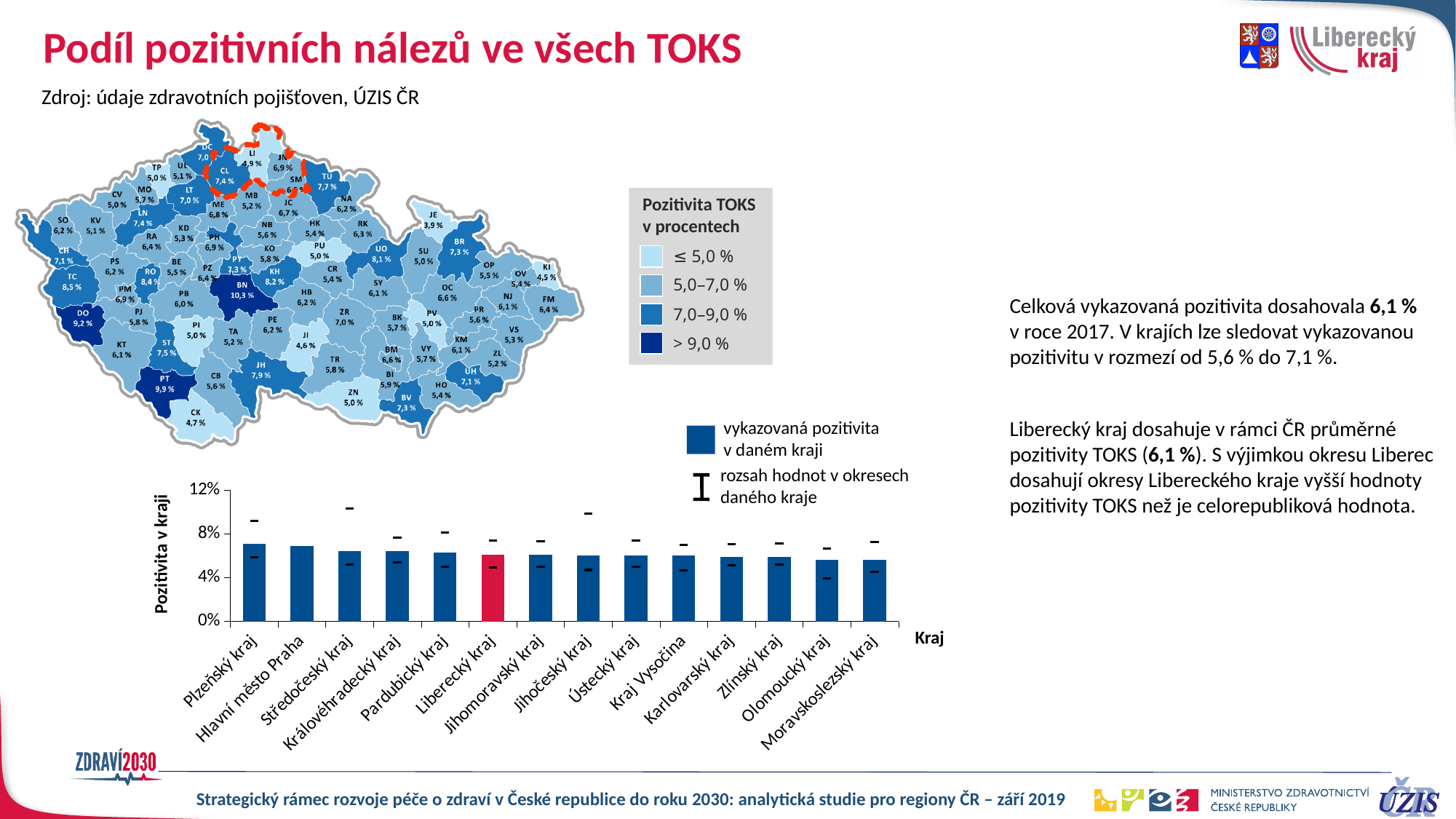
In the bar chart, which region's bar is highlighted in red? Liberecký kraj How many entries does the legend of the bar chart list? 2 What kind of chart is shown at the bottom of the slide? bar chart In the bar chart, which region has the highest positivity? Plzeňský kraj In the bar chart, is the value for Moravskoslezský kraj greater or less than 8%? less In the bar chart, do the bar values rise or fall from left to right? fall On the map, which district has the lowest positivity value? JE On the map, what positivity value is shown for district BN? 10,3 % In the bar chart, how many regions (kraje) are shown on the x axis? 14 On the map, what positivity value is shown for district PT? 9,9 % In the bar chart, is the value for Plzeňský kraj greater or less than 4%? greater In the bar chart, which is larger: the value for Hlavní město Praha or the value for Olomoucký kraj? Hlavní město Praha